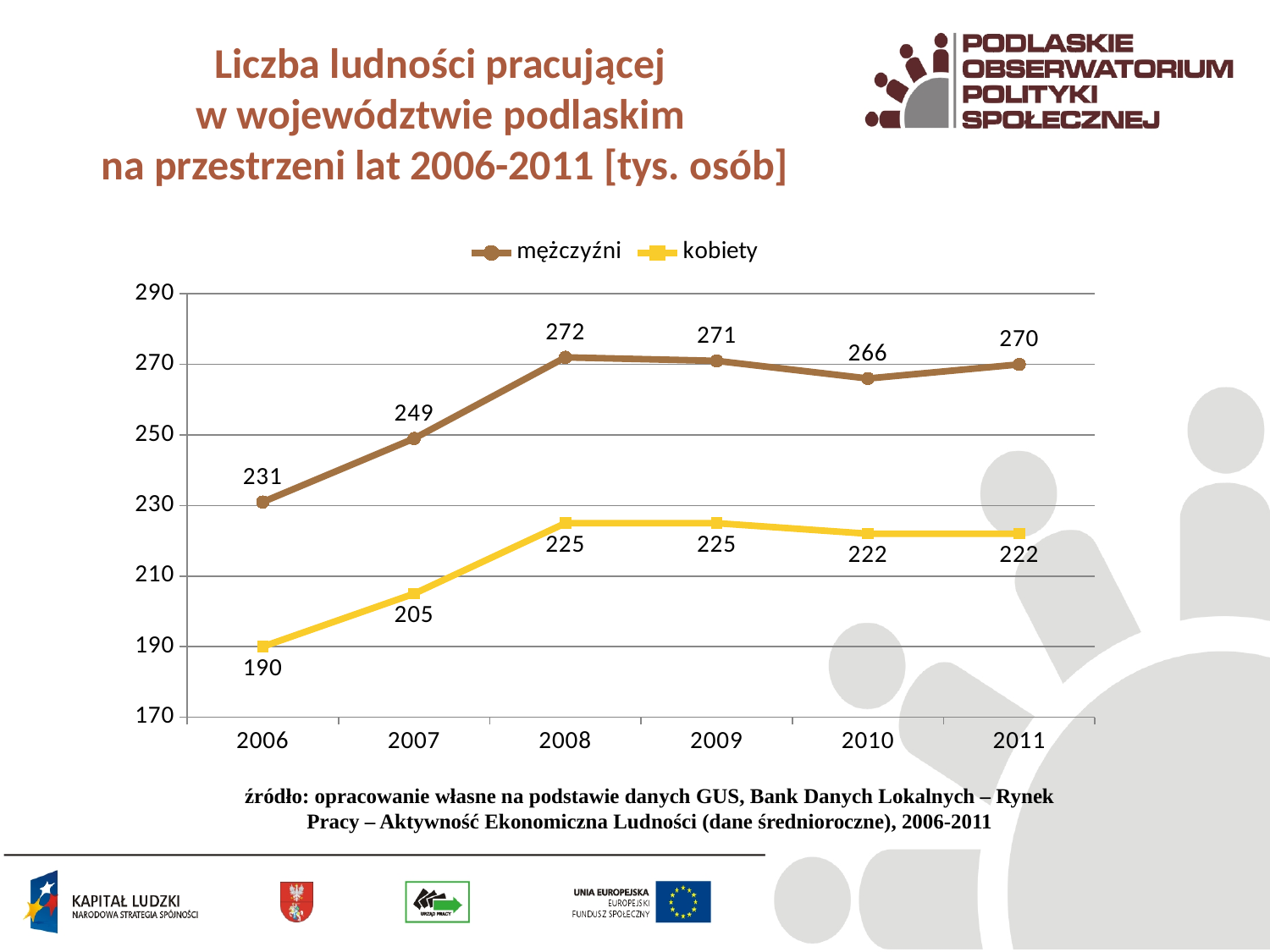
What kind of chart is shown on the slide? line chart What is the value for mężczyźni in 2008? 272 Which is larger: the value for mężczyźni in 2007 or in 2010? 2010 What is the value for kobiety in 2006? 190 How many years are shown on the x axis? 6 Is the value for kobiety in 2009 greater or less than 230? less What is the difference between mężczyźni and kobiety in 2011? 48 Does the value for mężczyźni rise or fall from 2006 to 2008? rise In which year is the value for mężczyźni highest? 2008 What is the value for kobiety in 2010? 222 In which year is the value for kobiety lowest? 2006 How many series does the legend list? 2